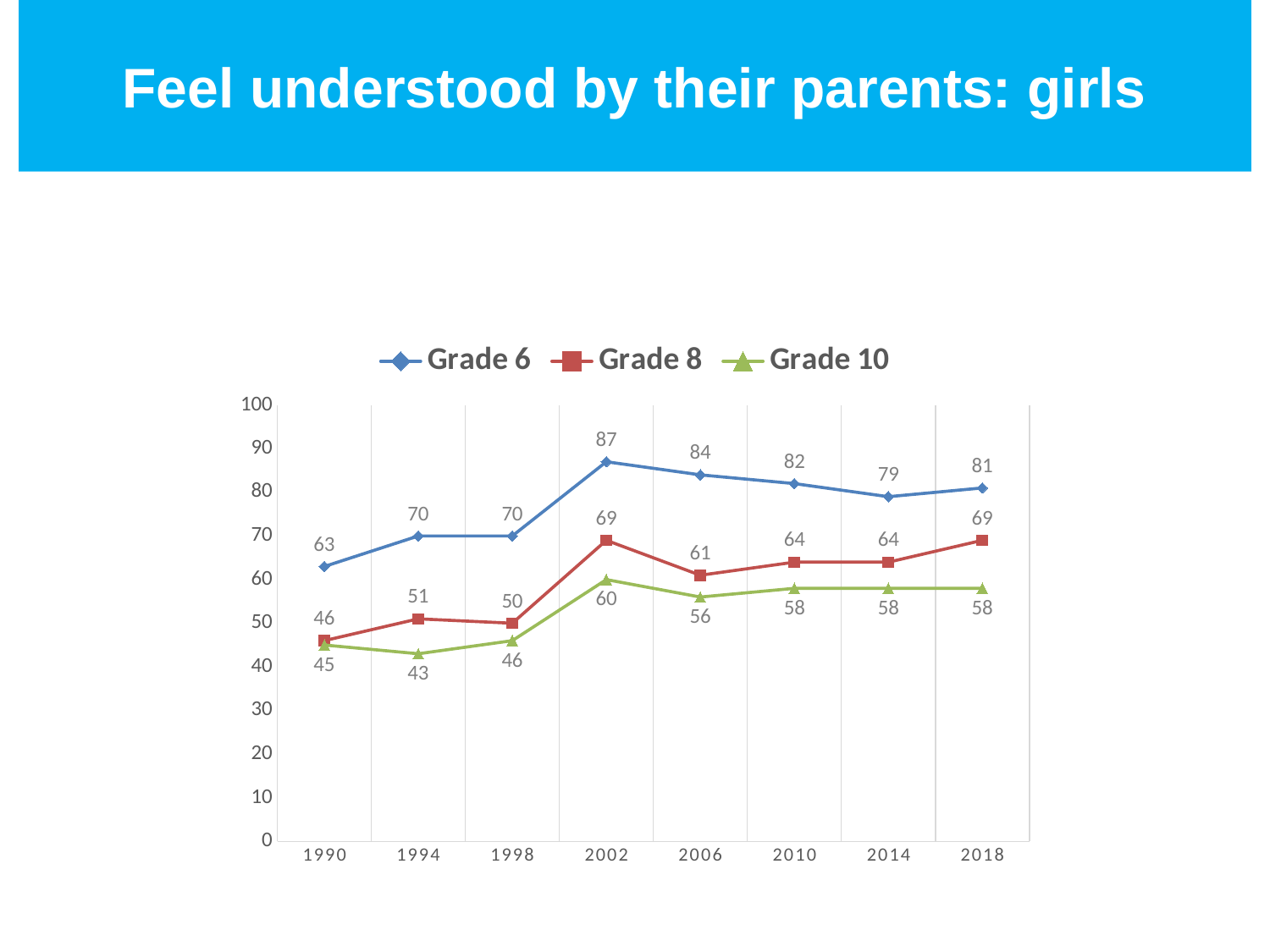
What is the value for Grade 10 in 2018? 58 In which year is the Grade 10 value lowest? 1994 What is the value for Grade 8 in 1994? 51 What is the value for Grade 6 in 2002? 87 In which year is the Grade 6 value highest? 2002 Which is larger in 2006: the Grade 8 value or the Grade 10 value? Grade 8 What kind of chart is shown on the slide? Line chart What is the title of the chart on the slide? Feel understood by their parents: girls What is the difference between the Grade 6 and Grade 8 values in 2018? 12 Did the Grade 6 value rise or fall from 1990 to 2002? Rise How many series does the legend list? 3 How many years are shown on the x axis? 8